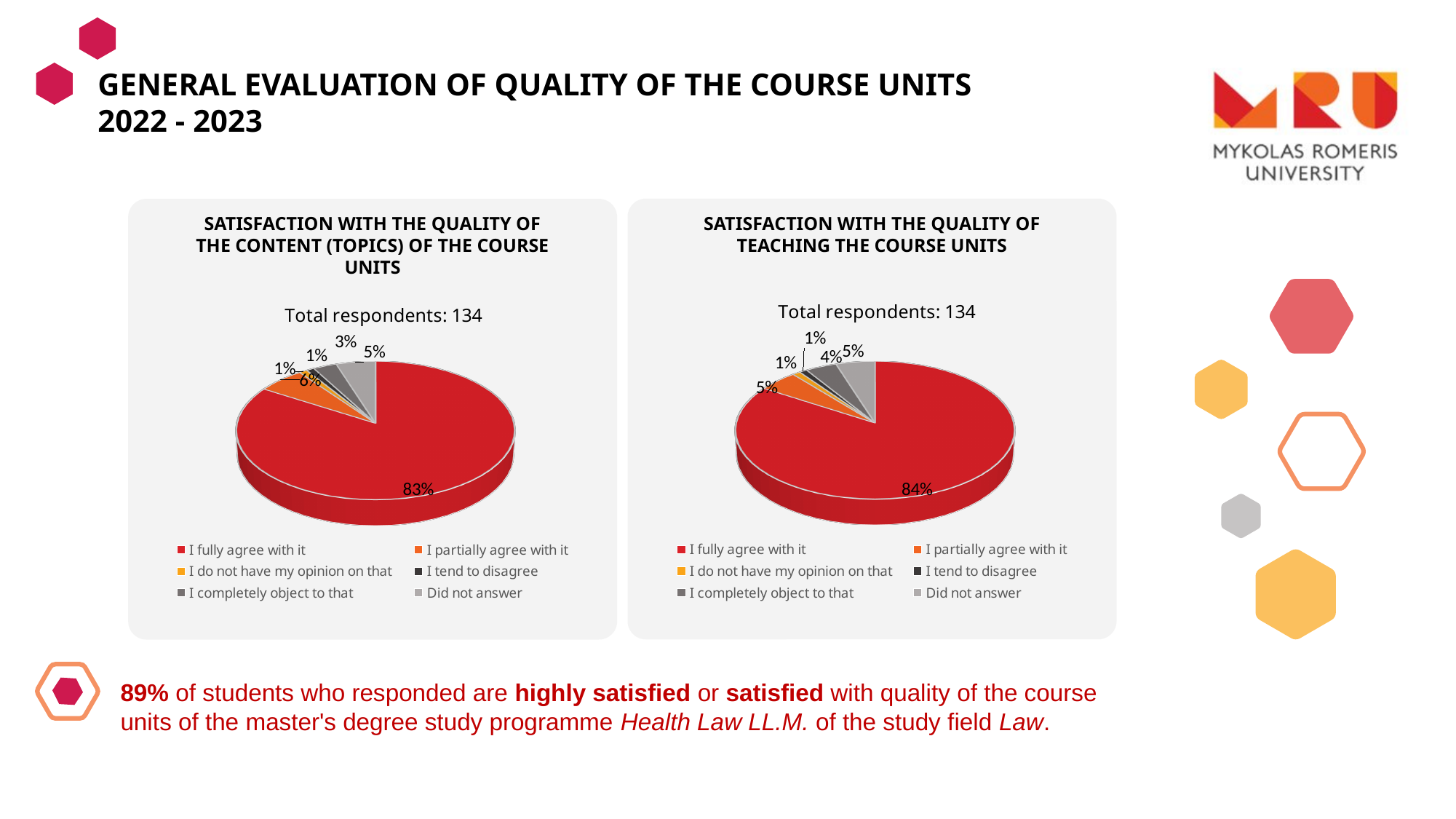
In the left chart (content of the course units), what percentage did not answer? 5% In the right chart (teaching the course units), what share of respondents partially agree with it? 5% In the chart titled 'Satisfaction with the quality of teaching the course units', what percentage of respondents fully agree with it? 84% In the chart titled 'Satisfaction with the quality of the content (topics) of the course units', what percentage of respondents fully agree with it? 83% What type of chart is used on this slide for both satisfaction charts? Pie chart How many total respondents are reported for the chart on satisfaction with the quality of teaching the course units? 134 How many response categories does the legend of the left chart (content of the course units) list? 6 What is the difference between the 'I fully agree with it' share in the right chart (84%) and the left chart (83%)? 1% In the left chart (content of the course units), what share of respondents partially agree with it? 6% In the right chart (teaching the course units), which response category has the largest slice? I fully agree with it Which is larger: the 'I fully agree with it' share in the left chart (content) or in the right chart (teaching)? Right chart (teaching), 84% In the left chart (content of the course units), which response category has the largest slice? I fully agree with it